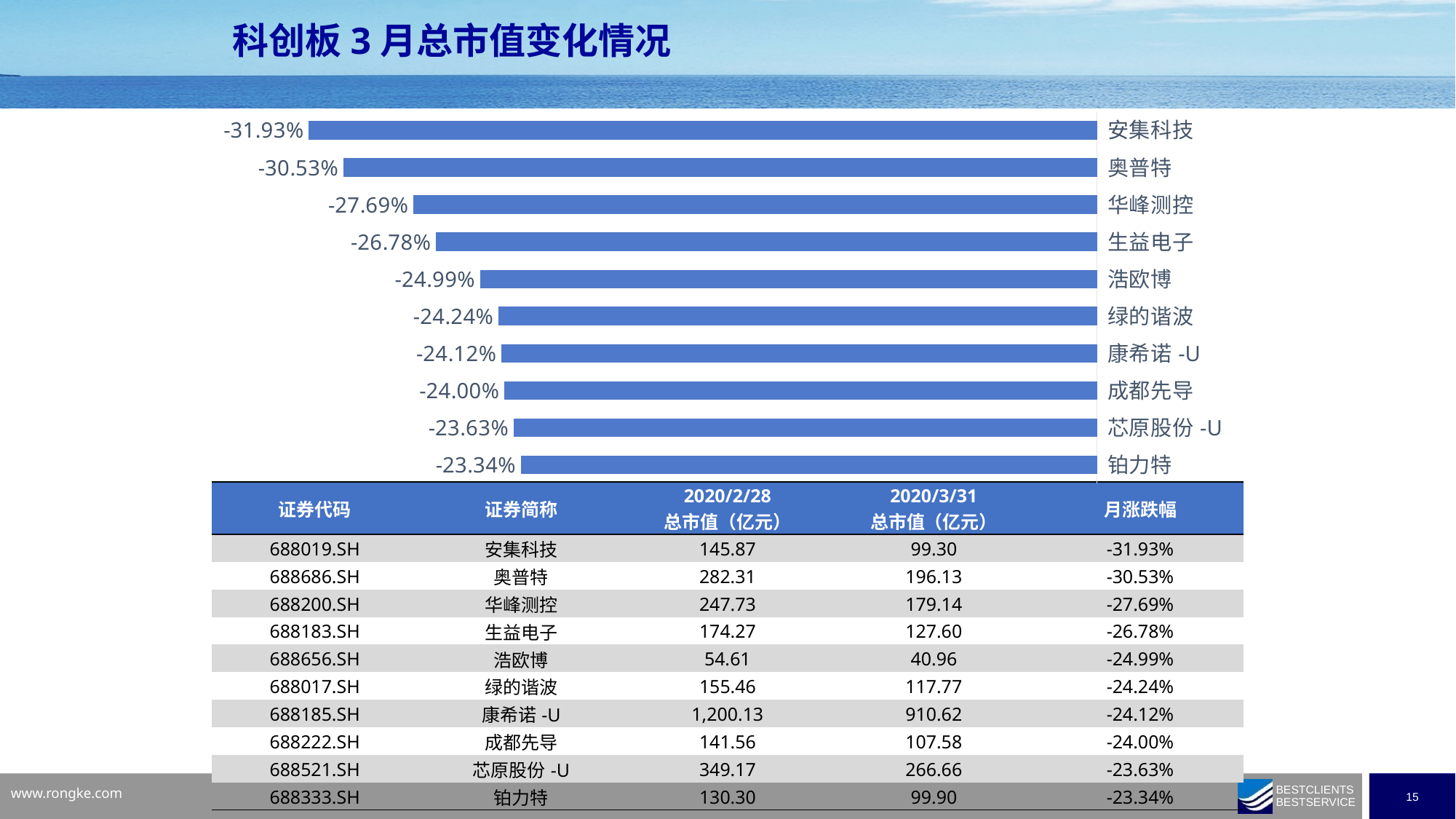
What is the value shown for 安集科技 in the bar chart? -31.93% What is the value shown for 浩欧博 in the bar chart? -24.99% Which category has the highest (least negative) value in the bar chart? 铂力特 What is the difference between the values for 安集科技 and 奥普特 in the bar chart? 1.40 percentage points Which has a larger decline in the bar chart, 华峰测控 or 生益电子? 华峰测控 What is the value shown for 康希诺 -U in the bar chart? -24.12% What is the value shown for 铂力特 in the bar chart? -23.34% What is the difference between the values for 成都先导 and 芯原股份 -U in the bar chart? 0.37 percentage points Which category has the lowest (most negative) value in the bar chart? 安集科技 What kind of chart is shown on the slide? Bar chart What is the title of the slide containing the bar chart? 科创板 3 月总市值变化情况 How many categories are shown in the bar chart? 10